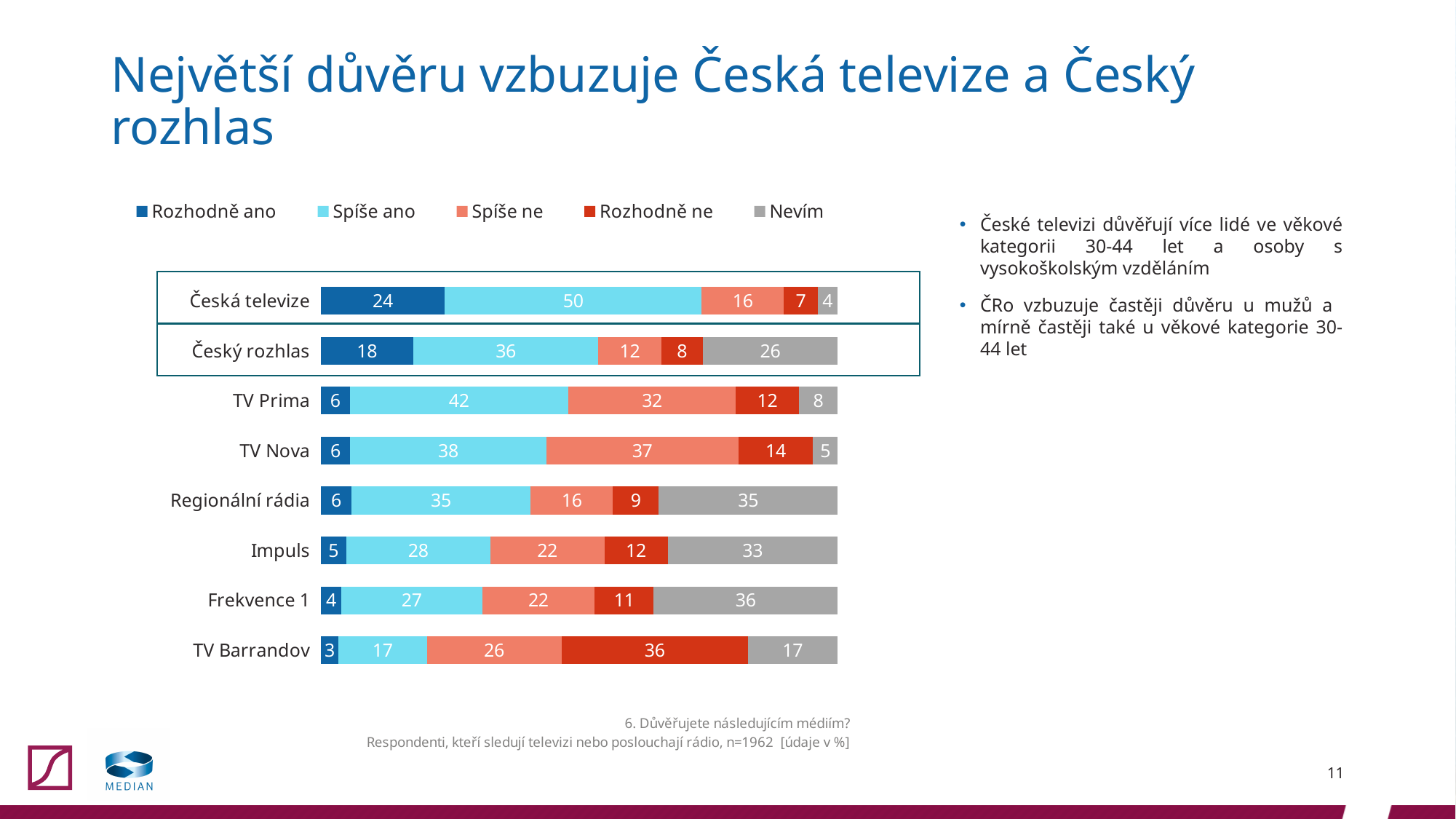
Which has a larger "Spíše ne" value, TV Nova or TV Prima? TV Nova Which medium has the lowest "Rozhodně ano" value? TV Barrandov How many series does the legend list? 5 What is the total of the stacked bar for Český rozhlas? 100 What is the value of "Rozhodně ano" for Česká televize? 24 Which medium has the highest "Rozhodně ano" value? Česká televize What is the difference between the "Spíše ano" values for Česká televize and Český rozhlas? 14 What is the value of "Rozhodně ne" for TV Barrandov? 36 How many media (categories) are shown in the chart? 8 What kind of chart is shown on the slide? Stacked bar chart What is the value of "Nevím" for Český rozhlas? 26 What is the value of "Spíše ne" for TV Nova? 37